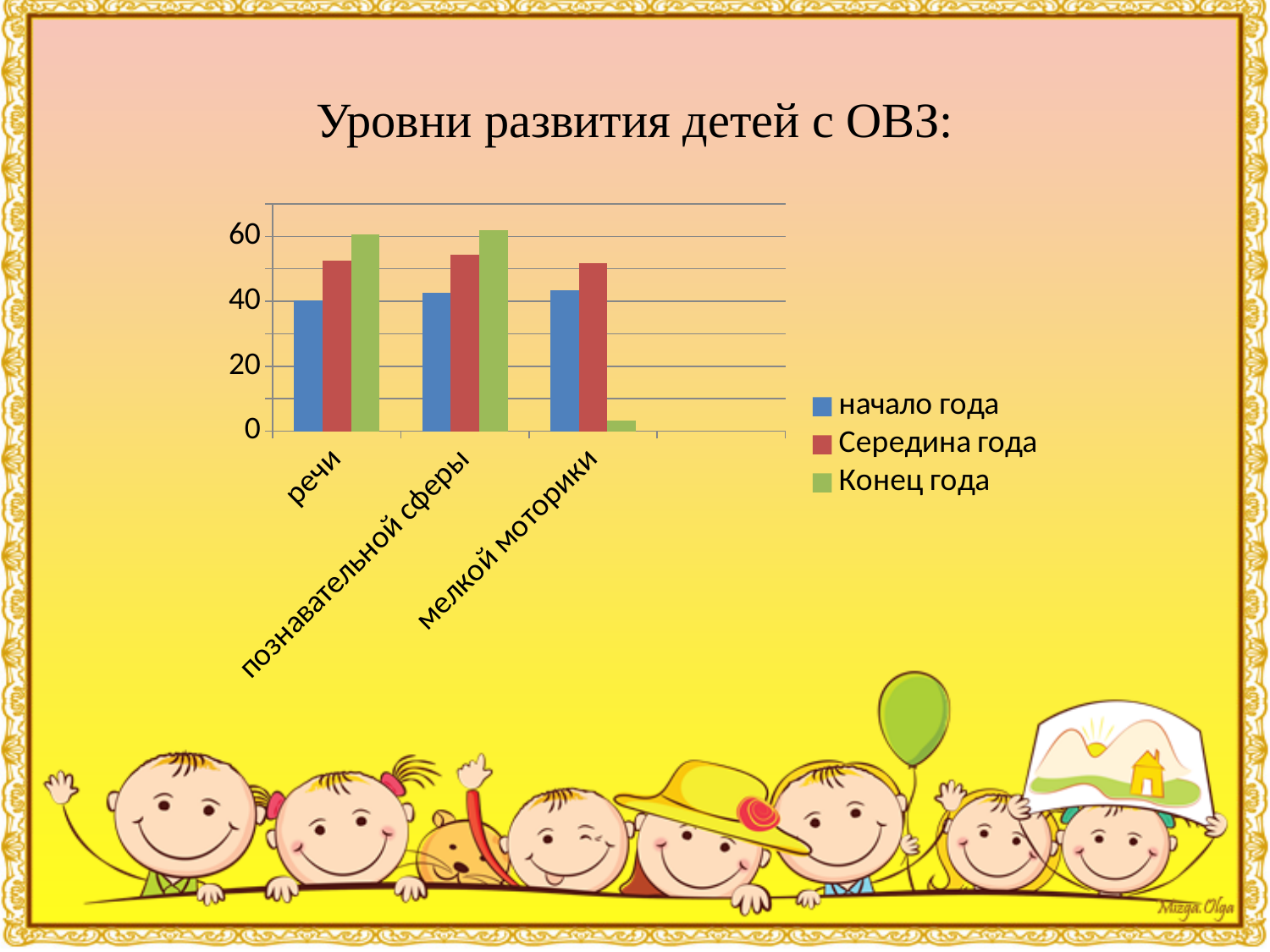
Is the value for "Конец года" in the category "мелкой моторики" greater or less than 20? less Which colour represents the series "Конец года" in the chart? green How many series does the chart's legend list? 3 For the series "Конец года", which category has the lowest value? мелкой моторики What kind of chart is shown on the slide? bar chart Is the value for "Середина года" in the category "речи" greater or less than 40? greater What is the title of the slide above the chart? Уровни развития детей с ОВЗ: Is the value for "Середина года" in the category "мелкой моторики" greater or less than 60? less How many categories are shown on the x axis of the chart? 3 In the category "речи", which series has the highest value? Конец года For the series "Конец года", which is larger: the value for "речи" or the value for "мелкой моторики"? речи In the category "мелкой моторики", which series has the highest value? Середина года